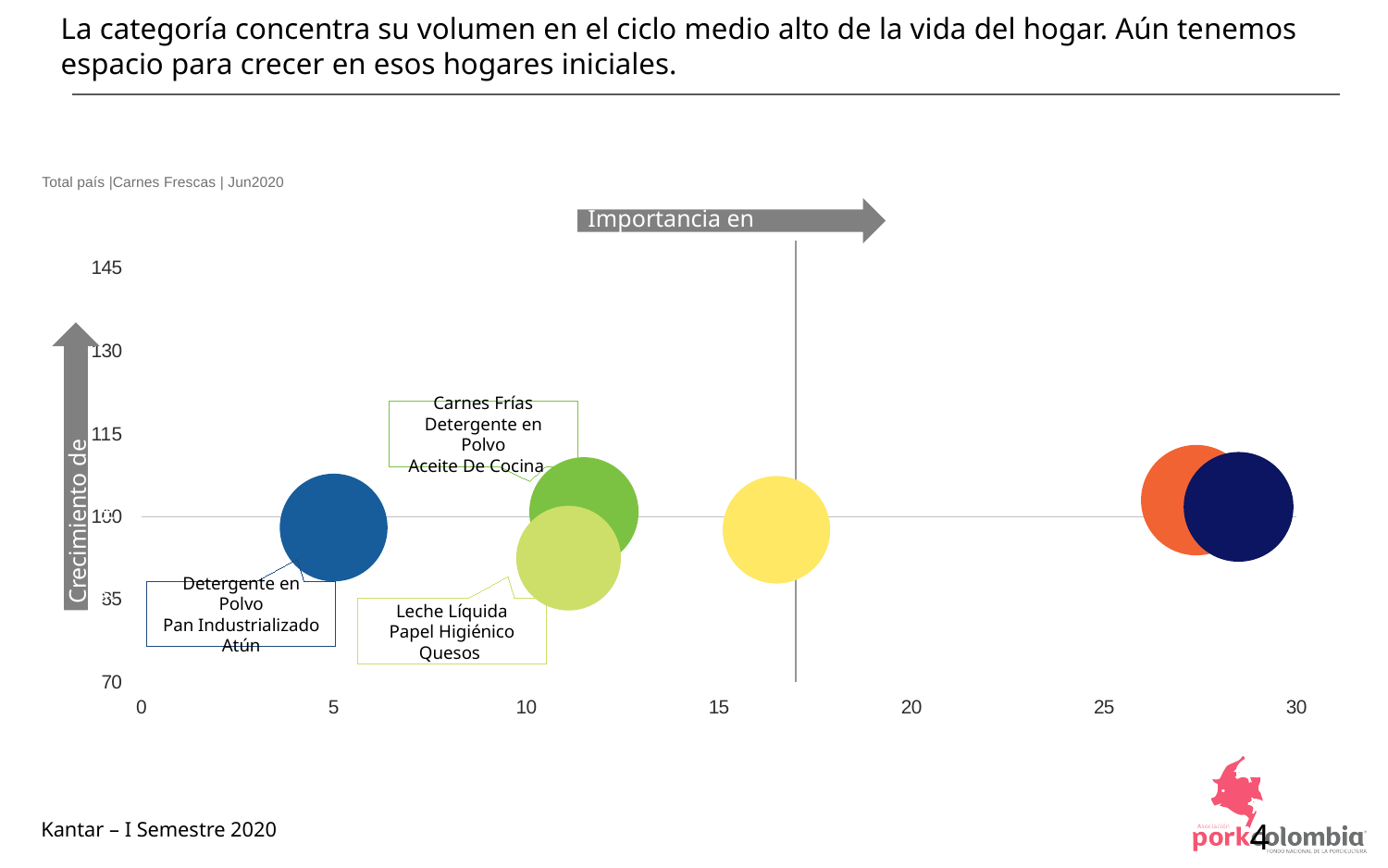
Is the horizontal-axis value of the yellow bubble greater or less than 15? greater Is the horizontal-axis value of the orange bubble greater or less than 25? greater Which bubble is positioned furthest to the left on the horizontal axis? the dark blue bubble Is the horizontal-axis value of the navy bubble on the far right greater or less than 25? greater What kind of chart is shown on the slide? bubble chart What is the highest value shown on the vertical axis? 145 What label is shown on the horizontal arrow above the chart? Importancia en Which bubble is positioned furthest to the right on the horizontal axis? the navy bubble How many bubbles are plotted on the chart? 6